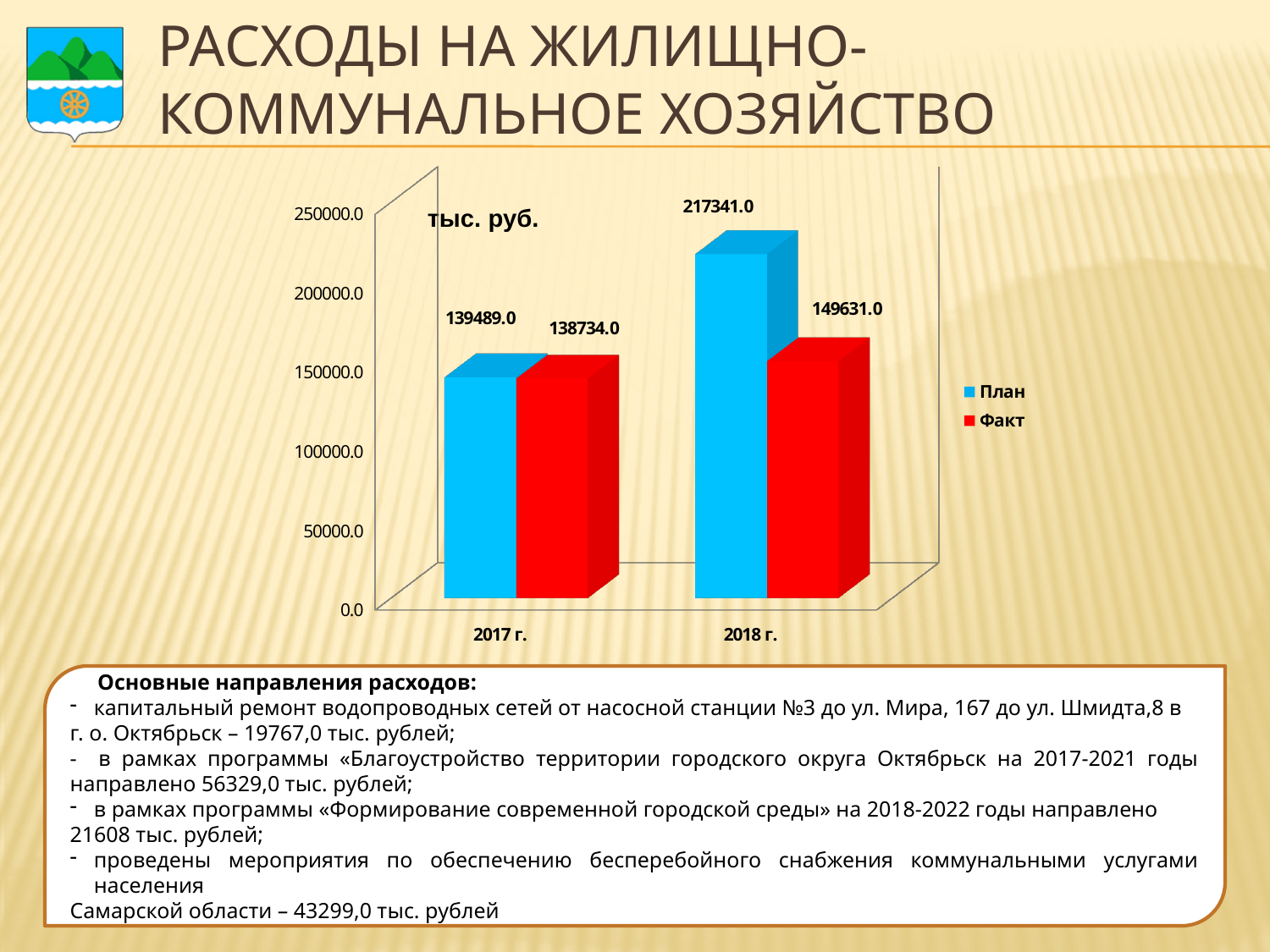
What unit label is shown inside the chart area? тыс. руб. How many series does the legend list? 2 Which year has the higher План value? 2018 г. By how much did the План value increase from 2017 г. to 2018 г.? 77852.0 What is the План value for 2017 г.? 139489.0 What is the difference between the План and Факт values for 2018 г.? 67710.0 Which year has the lower Факт value? 2017 г. What is the Факт value for 2017 г.? 138734.0 What kind of chart is shown on the slide? Bar chart What is the План value for 2018 г.? 217341.0 Which is larger for 2018 г., План or Факт? План What is the Факт value for 2018 г.? 149631.0